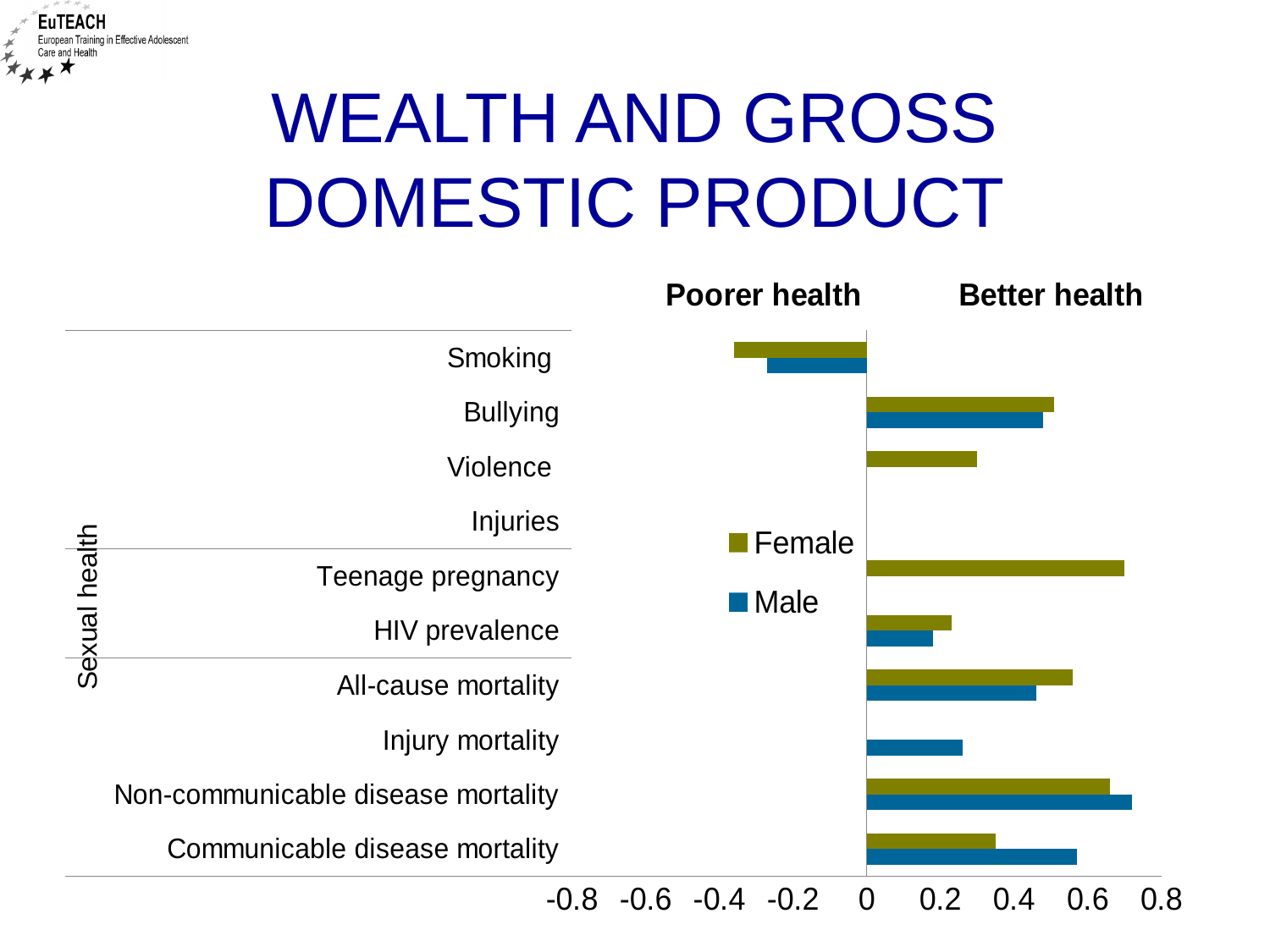
Is the Male value for Injury mortality greater or less than 0.4? less What kind of chart is shown on the slide? bar chart Which category has the highest Male value? Non-communicable disease mortality Is the Male value for Non-communicable disease mortality greater or less than 0.6? greater Is the Female value for Smoking greater or less than -0.2? less How many categories are plotted on the chart? 10 Which category is the only one with negative values for both Female and Male? Smoking For Communicable disease mortality, which is larger, the Female value or the Male value? Male For All-cause mortality, which is larger, the Female value or the Male value? Female How many series does the legend list? 2